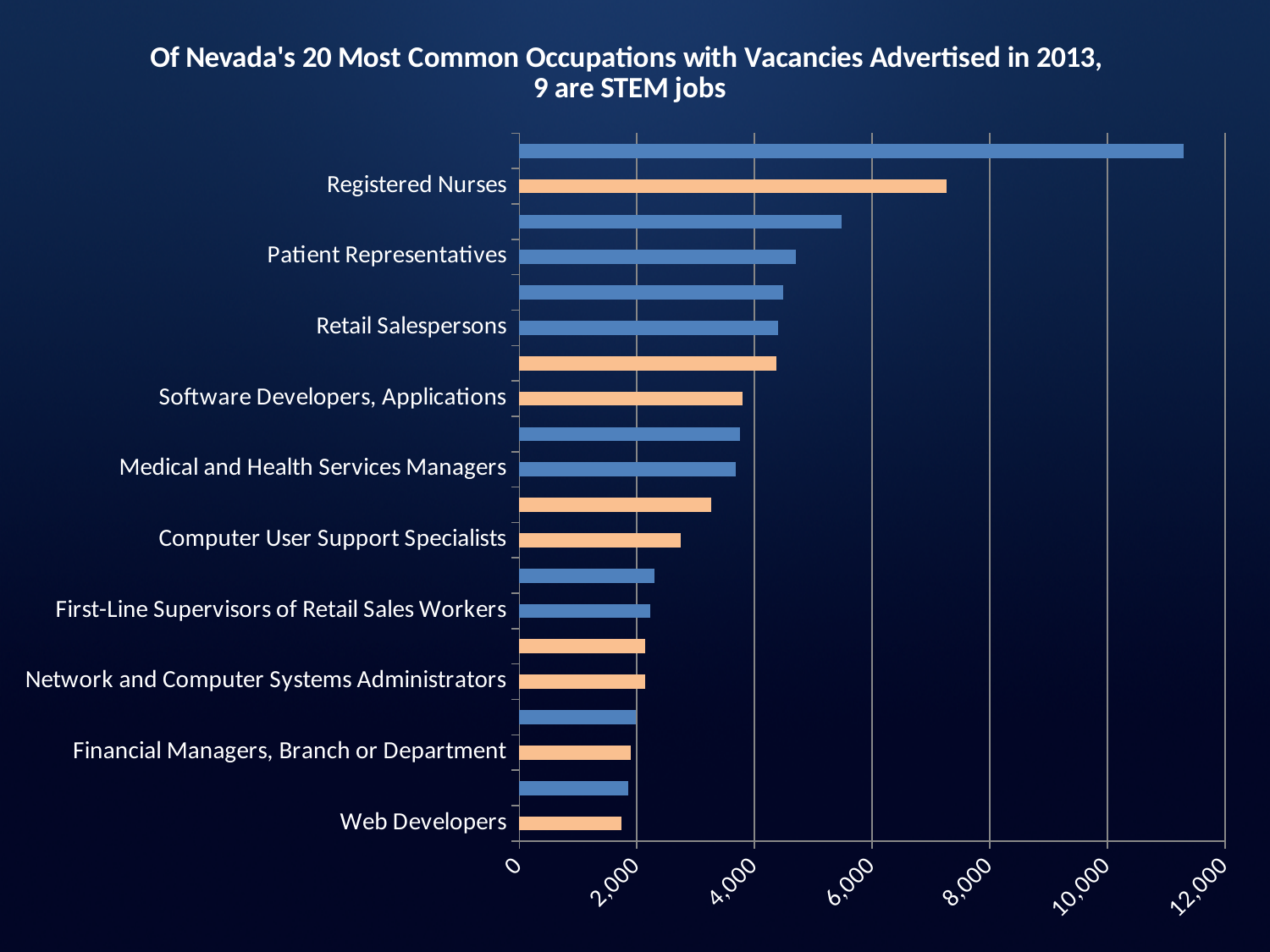
Is the value for Patient Representatives greater or less than 4,000? greater What is the highest value shown on the horizontal axis? 12,000 Which has the larger value, Retail Salespersons or Web Developers? Retail Salespersons Is the value for Web Developers greater or less than 2,000? less Is the value for Computer User Support Specialists greater or less than 2,000? greater Which has the larger value, Registered Nurses or Patient Representatives? Registered Nurses Among the labeled occupations, which has the lowest value? Web Developers What kind of chart is shown on the slide? bar chart Do the bar values increase or decrease going from the top of the chart to the bottom? decrease How many bars are plotted in the chart? 20